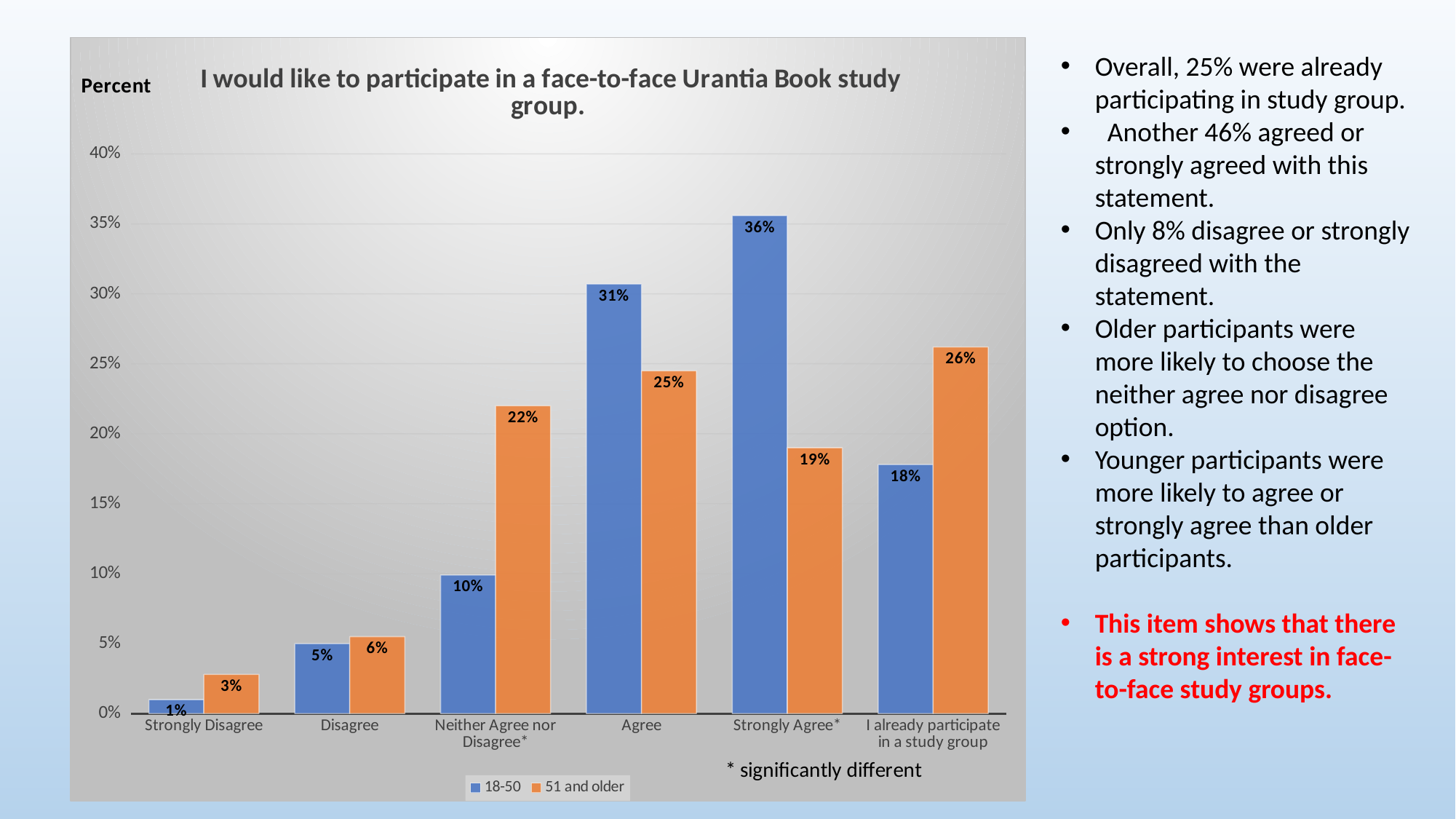
What is the difference between the 18-50 and 51 and older values in the Agree category? 6% What is the title of the chart? I would like to participate in a face-to-face Urantia Book study group. What kind of chart is shown on the slide? bar chart What is the value for the 18-50 series in the Strongly Agree* category? 36% Which category has the highest value for the 18-50 series? Strongly Agree* What is the value for the 51 and older series in the I already participate in a study group category? 26% Is the value for the 18-50 series in the Agree category greater or less than 25%? greater Which category has the lowest value for the 51 and older series? Strongly Disagree How many categories are shown on the x axis? 6 How many series does the legend list? 2 What is the value for the 51 and older series in the Neither Agree nor Disagree* category? 22% In the Neither Agree nor Disagree* category, which series has the larger value, 18-50 or 51 and older? 51 and older